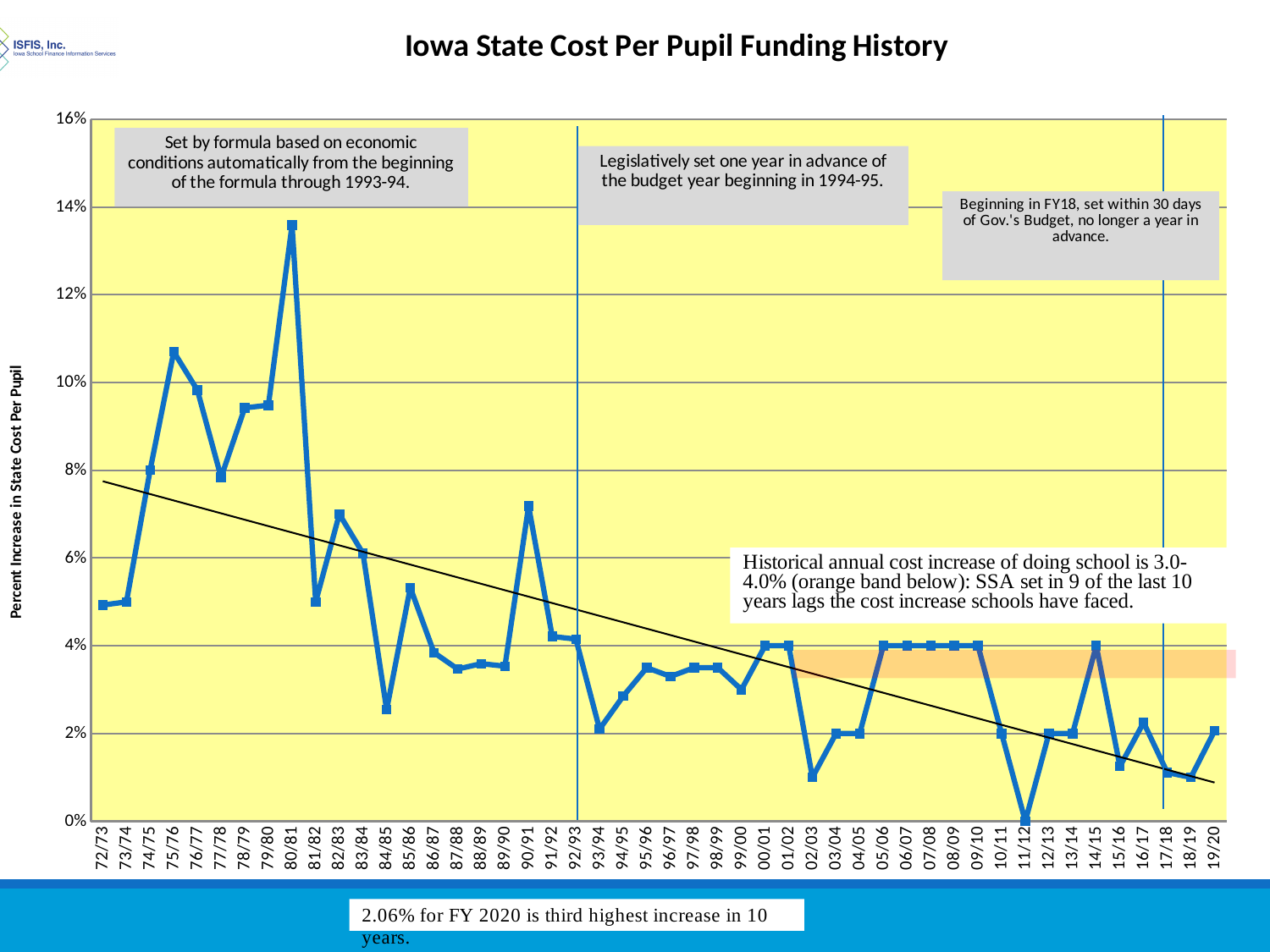
Which year has the highest percent increase in state cost per pupil? 80/81 Is the value for 84/85 greater or less than 4%? less Is the value for 75/76 greater or less than 10%? greater What is the percent increase for 05/06? 4% Is the value for 90/91 greater or less than 6%? greater What is the title of the chart? Iowa State Cost Per Pupil Funding History What is the percent increase for 11/12? 0% Which year has the lowest percent increase in state cost per pupil? 11/12 Which is larger, the value for 90/91 or the value for 91/92? 90/91 What is the percent increase for 74/75? 8% What kind of chart is shown on the slide? line chart Overall, do the values rise or fall from 72/73 to 19/20? fall